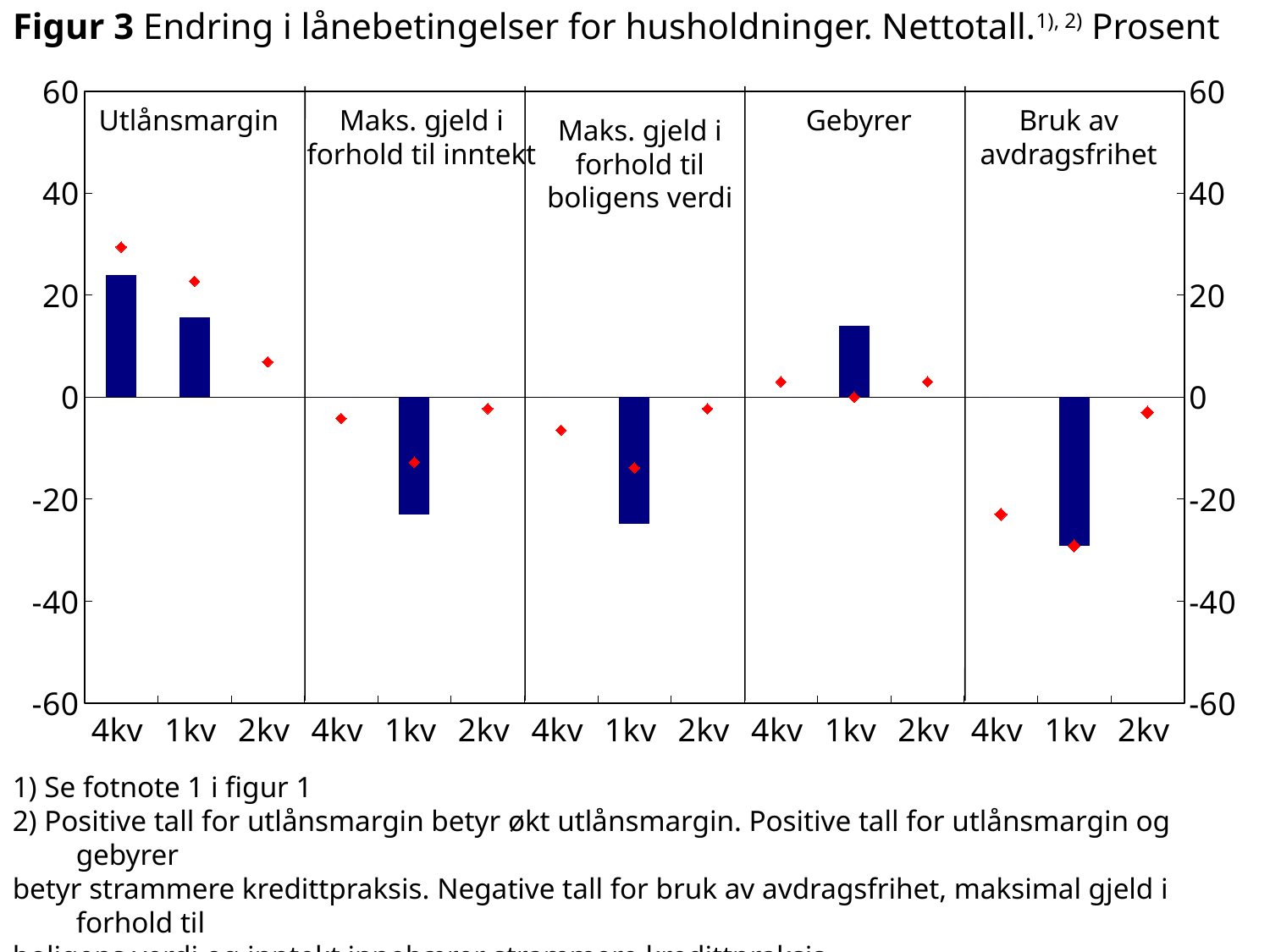
Which panel contains the tallest positive bar? Utlånsmargin In the Gebyrer panel, is the bar for 1kv greater or less than 20? less In the Utlånsmargin panel, which bar is larger, 4kv or 1kv? 4kv How many panels (loan condition categories) does the chart have? 5 What kind of chart is shown on the slide? combination chart with bars and diamond markers In the Utlånsmargin panel, is the bar for 4kv greater or less than 20? greater What are the minimum and maximum values shown on the y axis? -60 and 60 In the Maks. gjeld i forhold til inntekt panel, is the bar for 1kv greater or less than -20? less In the Utlånsmargin panel, do the bars rise or fall from 4kv to 1kv? fall How many quarters are shown on the x axis within each panel? 3 Which panel contains the lowest (most negative) bar? Bruk av avdragsfrihet